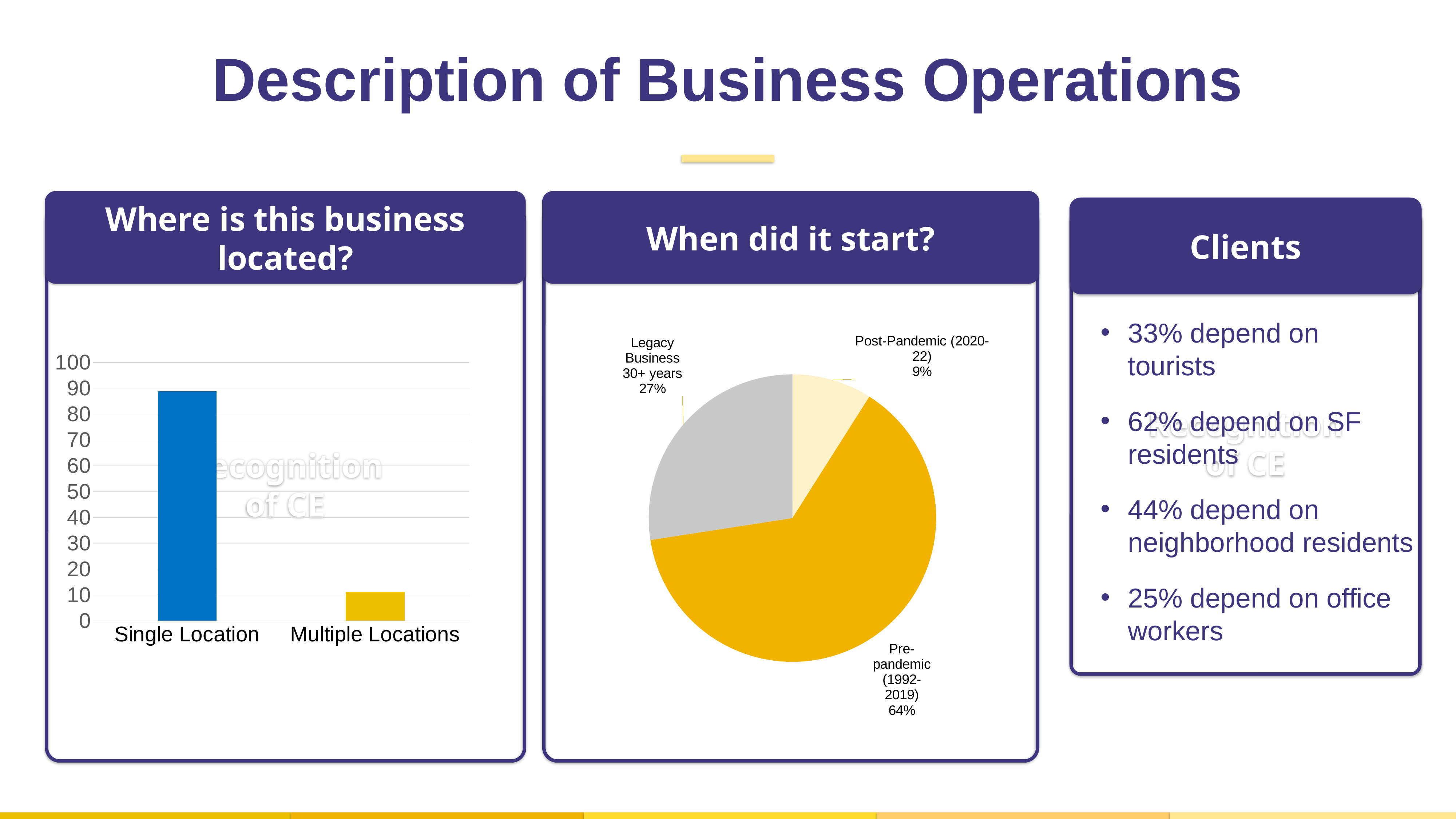
In the 'Where is this business located?' chart, which category has the highest value? Single Location In the 'Where is this business located?' chart, how many categories are shown on the x axis? 2 In the 'When did it start?' chart, how many slices does the pie have? 3 In the 'When did it start?' chart, what share of the pie is Legacy Business 30+ years? 27% In the 'Where is this business located?' chart, which category has the lowest value? Multiple Locations In the 'Where is this business located?' chart, is the value for Single Location greater or less than 80? greater In the 'Where is this business located?' chart, is the value for Multiple Locations greater or less than 20? less In the 'When did it start?' chart, what kind of chart is shown? pie chart In the 'When did it start?' chart, what share of the pie is Pre-pandemic (1992-2019)? 64% In the 'When did it start?' chart, which slice is the smallest? Post-Pandemic (2020-22) In the 'Where is this business located?' chart, what kind of chart is shown? bar chart In the 'When did it start?' chart, what is the difference in percentage points between the Pre-pandemic (1992-2019) slice and the Legacy Business 30+ years slice? 37